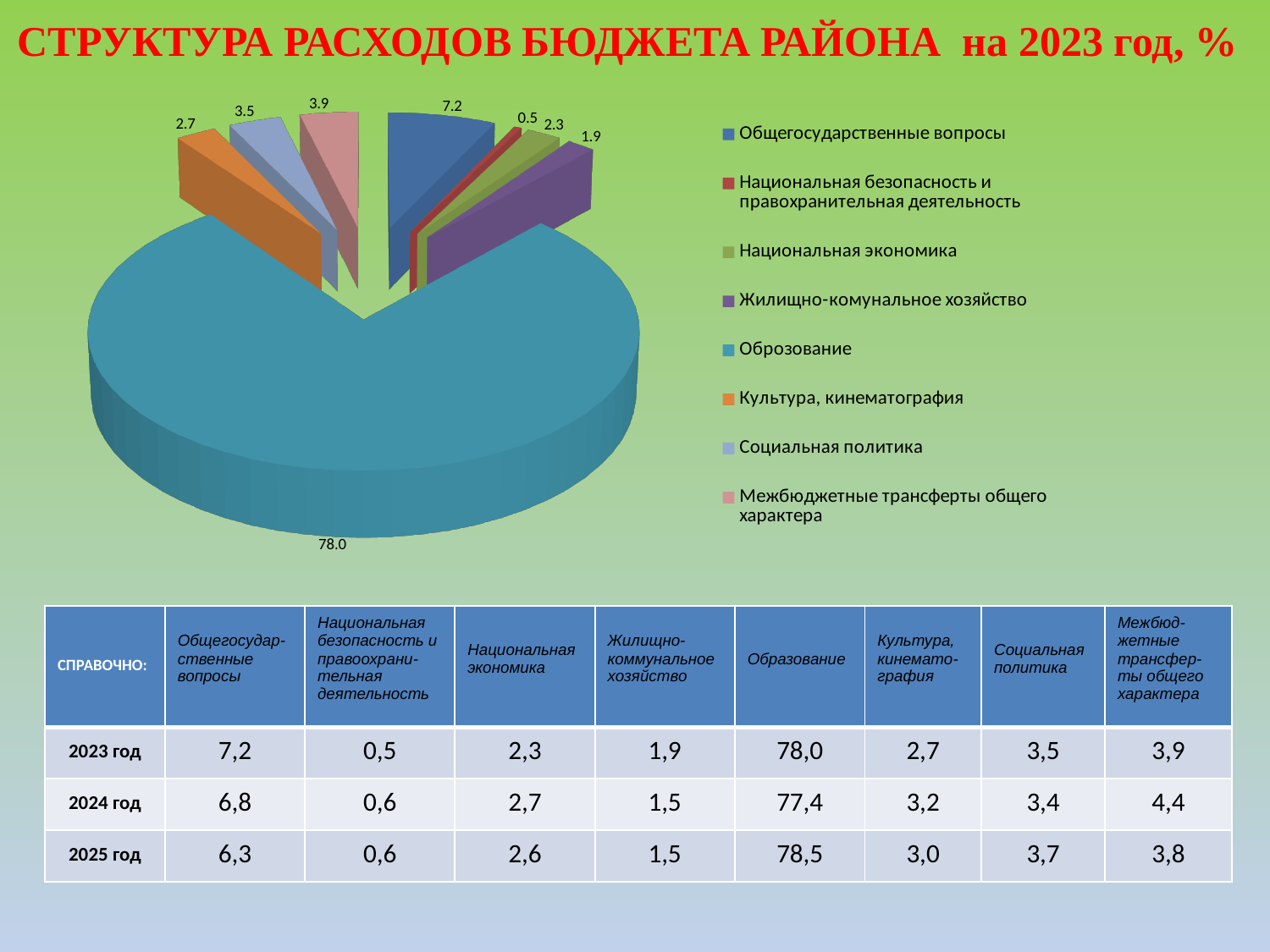
Which category has the smallest slice in the pie chart? Национальная безопасность и правохранительная деятельность What is the difference between the values for Социальная политика and Культура, кинематография in the pie chart? 0.8 Which category has the largest slice in the pie chart? Оброзование What is the title of the chart on the slide? СТРУКТУРА РАСХОДОВ БЮДЖЕТА РАЙОНА на 2023 год, % What is the value for Оброзование in the pie chart? 78.0 What is the value for Межбюджетные трансферты общего характера in the pie chart? 3.9 Which is larger in the pie chart: Национальная экономика or Жилищно-коммунальное хозяйство? Национальная экономика What is the value for Национальная безопасность и правохранительная деятельность in the pie chart? 0.5 What is the value for Общегосударственные вопросы in the pie chart? 7.2 What colour is the slice for Жилищно-коммунальное хозяйство in the pie chart? Purple What kind of chart is shown on the slide? Pie chart How many categories does the pie chart's legend list? 8